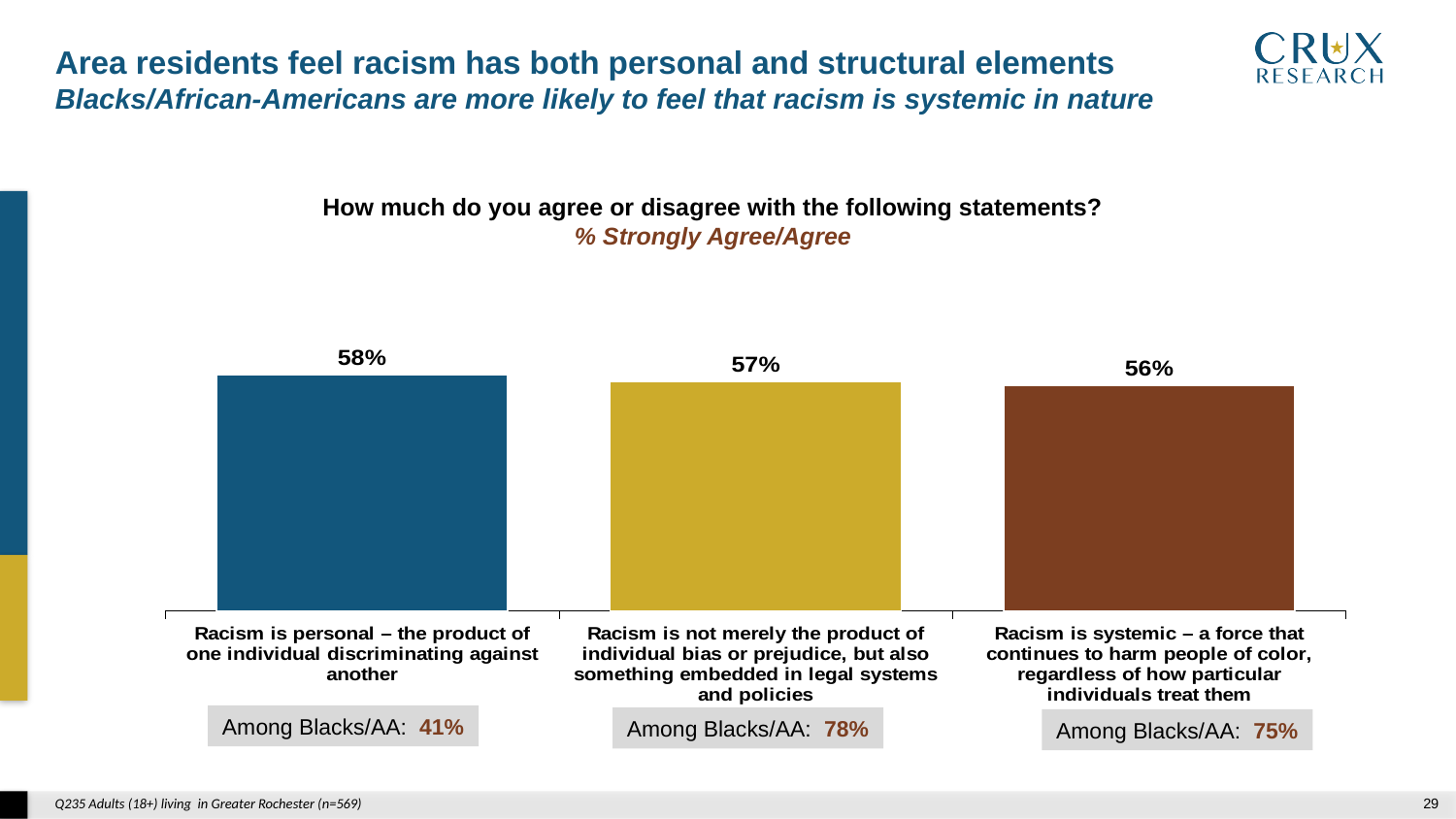
How many bars are shown in the chart? 3 Which statement has the lowest percentage of strongly agree/agree among all area residents? Racism is systemic – a force that continues to harm people of color, regardless of how particular individuals treat them What percentage strongly agree/agree that racism is systemic – a force that continues to harm people of color, regardless of how particular individuals treat them? 56% Among Blacks/AA, what percentage strongly agree/agree that racism is personal – the product of one individual discriminating against another? 41% Which statement has the highest percentage of strongly agree/agree among all area residents? Racism is personal – the product of one individual discriminating against another What type of chart is shown on the slide? Bar chart What is the subtitle shown under the chart's question heading? % Strongly Agree/Agree Among Blacks/AA, what percentage strongly agree/agree that racism is not merely the product of individual bias or prejudice, but also something embedded in legal systems and policies? 78% What percentage strongly agree/agree that racism is not merely the product of individual bias or prejudice, but also something embedded in legal systems and policies? 57% What percentage of area residents strongly agree/agree that racism is personal – the product of one individual discriminating against another? 58% What is the difference in percentage points between the 'racism is personal' bar and the 'racism is systemic' bar? 2 Do the bar values rise or fall from left to right across the chart? Fall